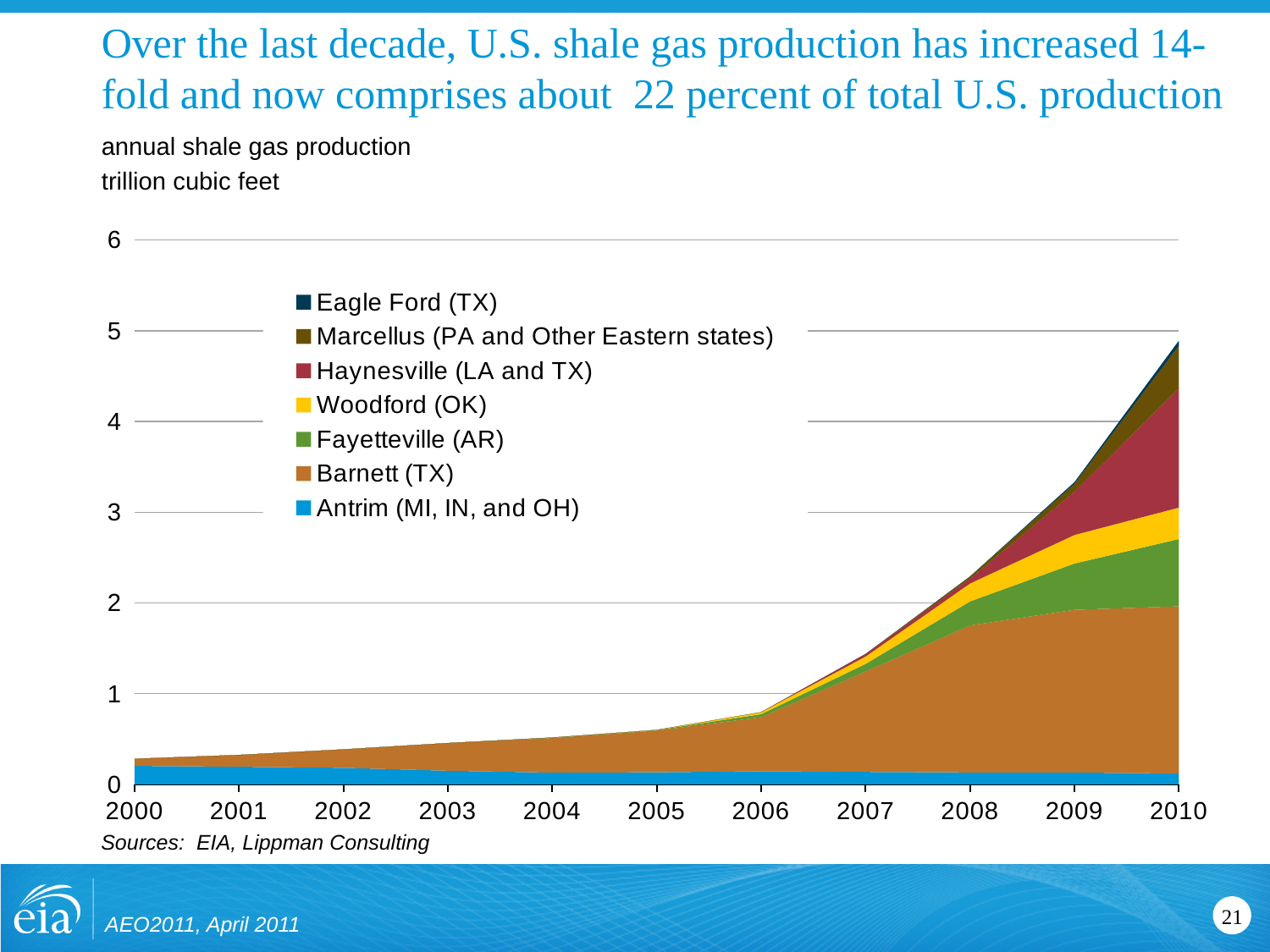
How many years are shown along the x axis? 11 What kind of chart is shown on the slide? stacked area chart Is the total shale gas production in 2006 greater or less than 1 trillion cubic feet? less Which is larger, total shale gas production in 2005 or in 2010? 2010 Is the total shale gas production in 2009 greater or less than 3 trillion cubic feet? greater Which year has the highest total shale gas production? 2010 Which year has the lowest total shale gas production? 2000 How many series does the legend list? 7 Which series contributes the most to shale gas production in 2010? Barnett (TX) Is the total shale gas production in 2010 greater or less than 4 trillion cubic feet? greater What unit is used for the y axis of the chart? trillion cubic feet Does total annual shale gas production rise or fall from 2000 to 2010? rise